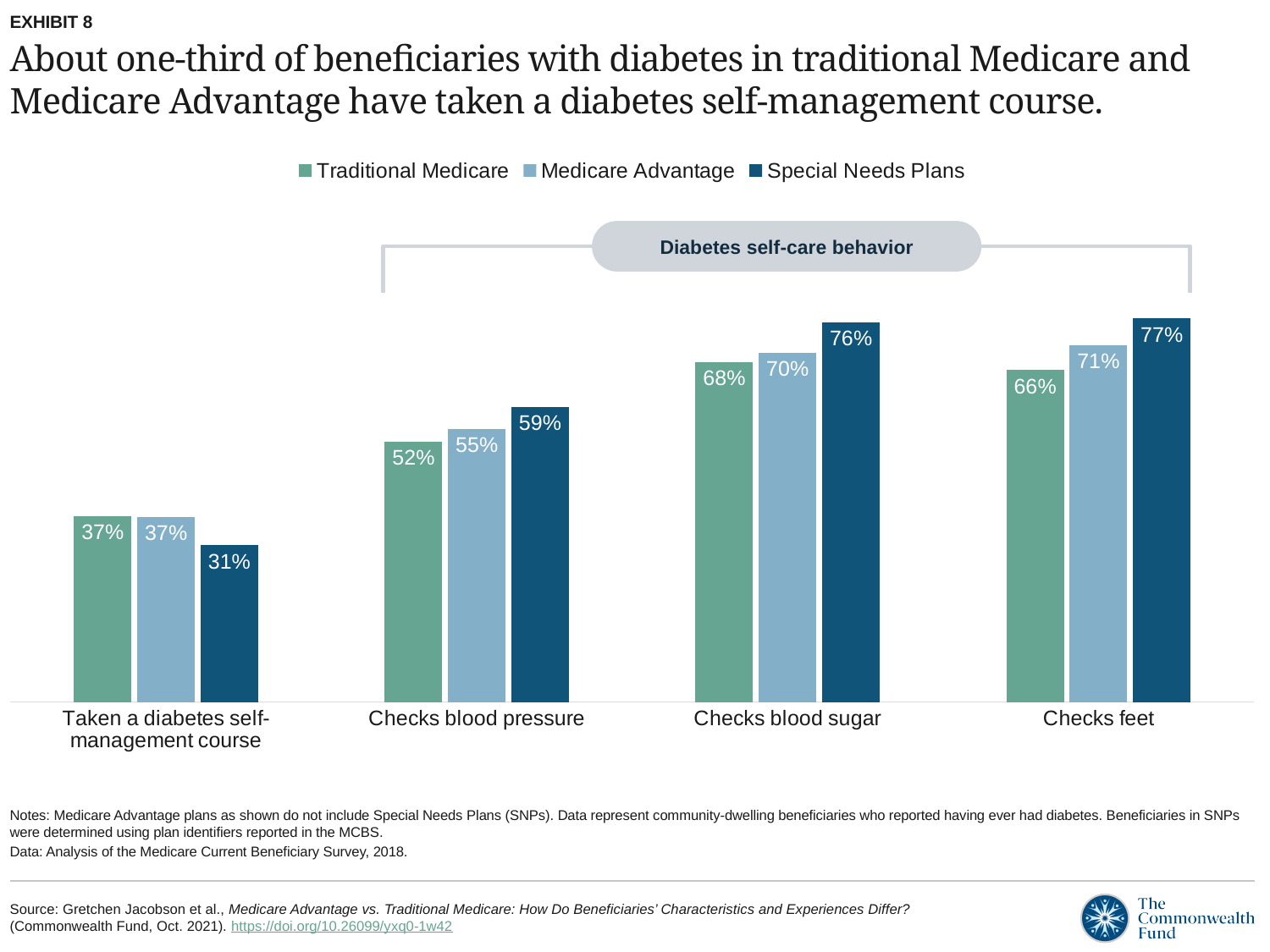
What is the difference between the Medicare Advantage values for 'Checks feet' and 'Checks blood pressure'? 16 percentage points What kind of chart is shown on the slide? Bar chart What is the difference between the Special Needs Plans and Traditional Medicare values for 'Checks blood sugar'? 8 percentage points Which category has the lowest value for Traditional Medicare? Taken a diabetes self-management course What is the value for Medicare Advantage in the 'Checks blood pressure' category? 55% How many categories are shown on the x axis? 4 Which category has the highest value for Special Needs Plans? Checks feet What is the value for Traditional Medicare in the 'Checks feet' category? 66% How many series does the legend list? 3 In the 'Checks blood pressure' category, which is larger: Traditional Medicare or Special Needs Plans? Special Needs Plans Which three categories are grouped under the label 'Diabetes self-care behavior'? Checks blood pressure, Checks blood sugar, Checks feet What percentage of Special Needs Plans beneficiaries have taken a diabetes self-management course? 31%